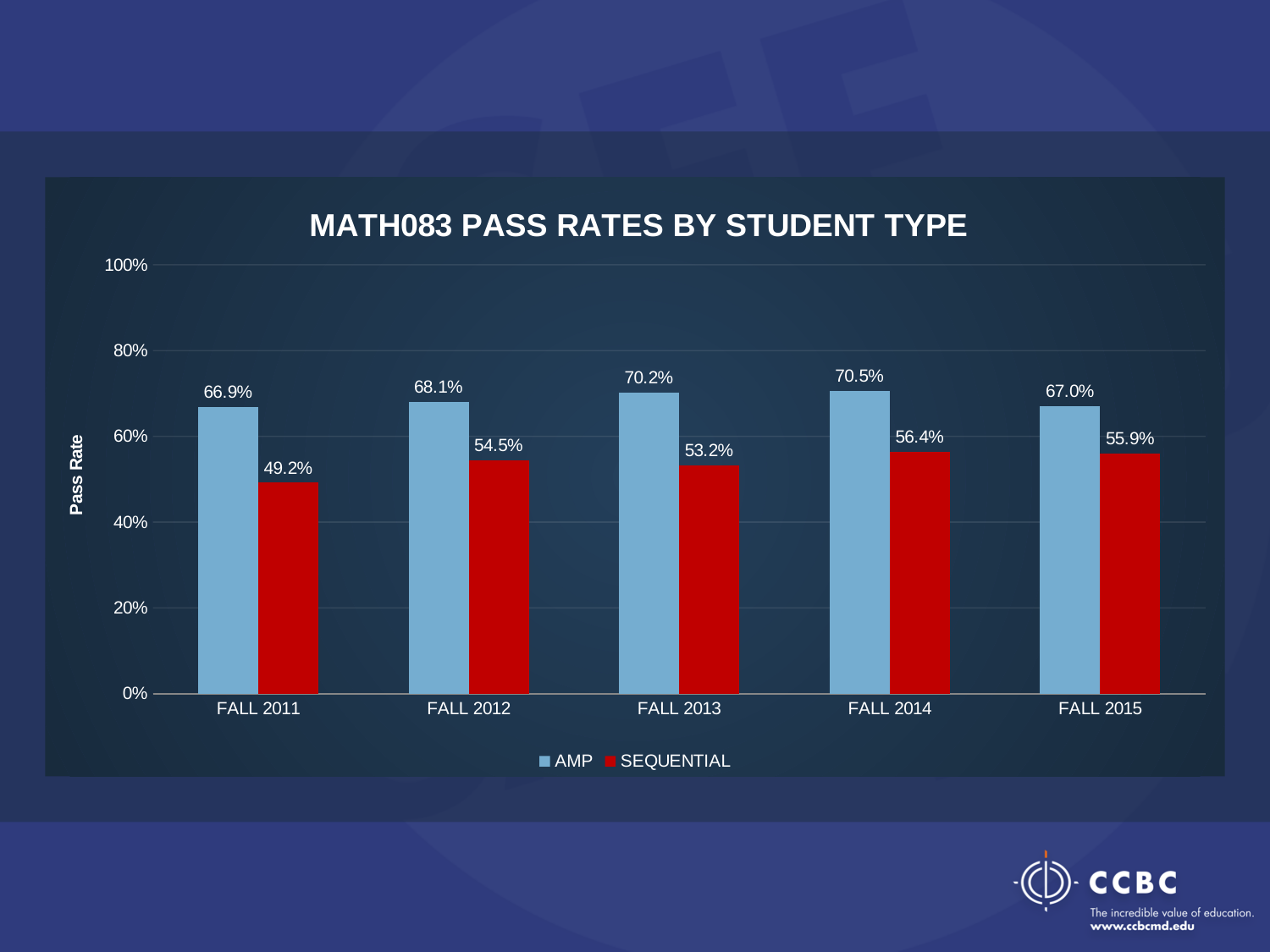
How many series does the legend list? 2 Is the SEQUENTIAL pass rate for FALL 2012 greater or less than 60%? less How many semesters are shown on the x axis? 5 In which semester is the SEQUENTIAL pass rate lowest? FALL 2011 In which semester is the AMP pass rate highest? FALL 2014 What is the AMP pass rate for FALL 2013? 70.2% What is the difference between the AMP and SEQUENTIAL pass rates in FALL 2011? 17.7% Which has the higher pass rate in FALL 2014, AMP or SEQUENTIAL? AMP What is the title of the chart? MATH083 PASS RATES BY STUDENT TYPE What is the SEQUENTIAL pass rate for FALL 2015? 55.9% What is the SEQUENTIAL pass rate for FALL 2011? 49.2% What kind of chart is shown on the slide? bar chart